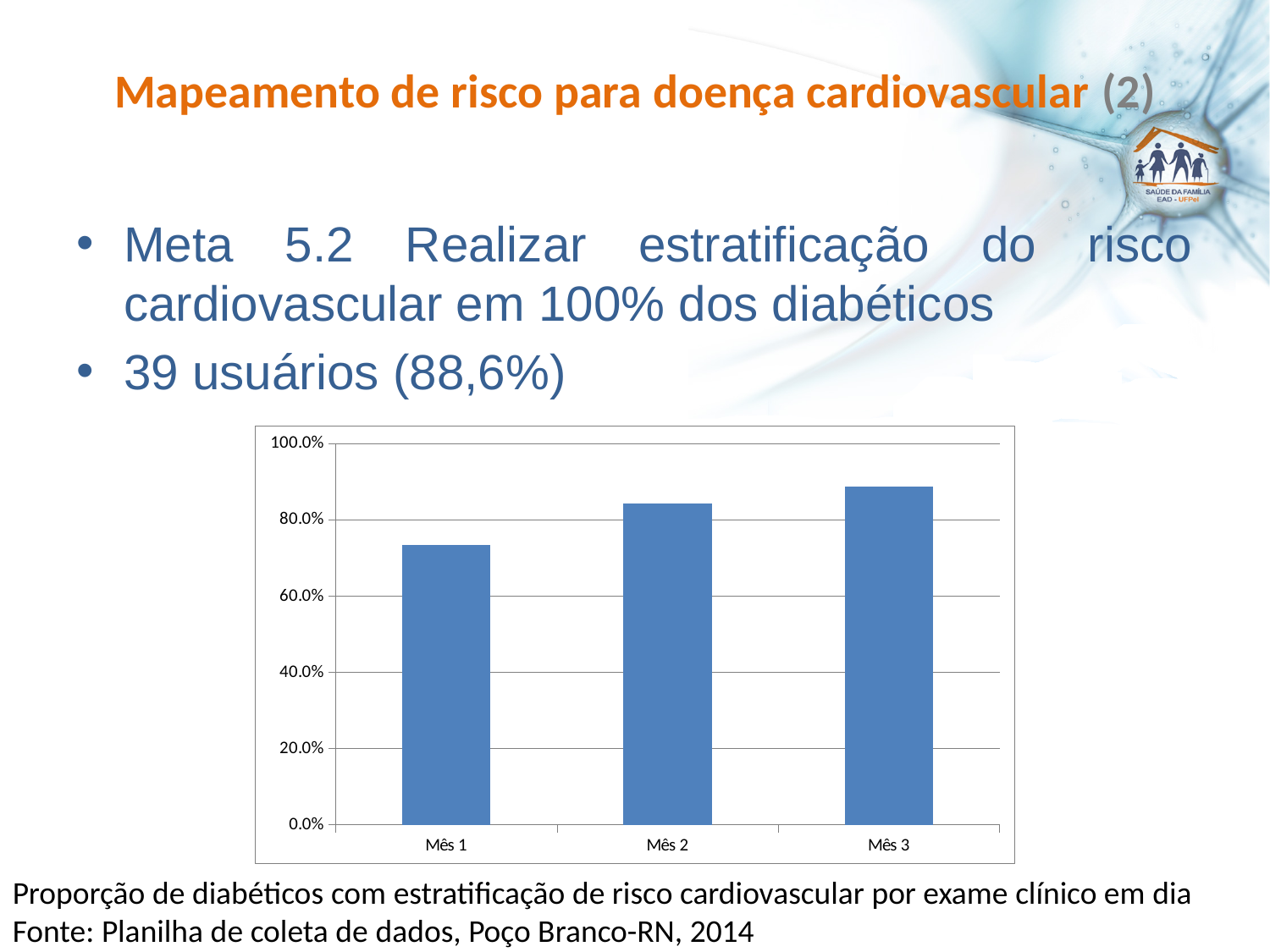
Is the value for Mês 1 greater or less than 60.0%? greater Is the value for Mês 2 greater or less than 80.0%? greater How many categories (bars) does the chart show? 3 Which is larger, the value for Mês 1 or the value for Mês 3? Mês 3 Which month has the lowest bar in the chart? Mês 1 Do the values rise or fall from Mês 1 to Mês 3? rise What is the highest value shown on the chart's vertical axis? 100.0% What kind of chart is shown on the slide? bar chart Which month has the highest bar in the chart? Mês 3 Is the value for Mês 1 greater or less than 80.0%? less Which is larger, the value for Mês 1 or the value for Mês 2? Mês 2